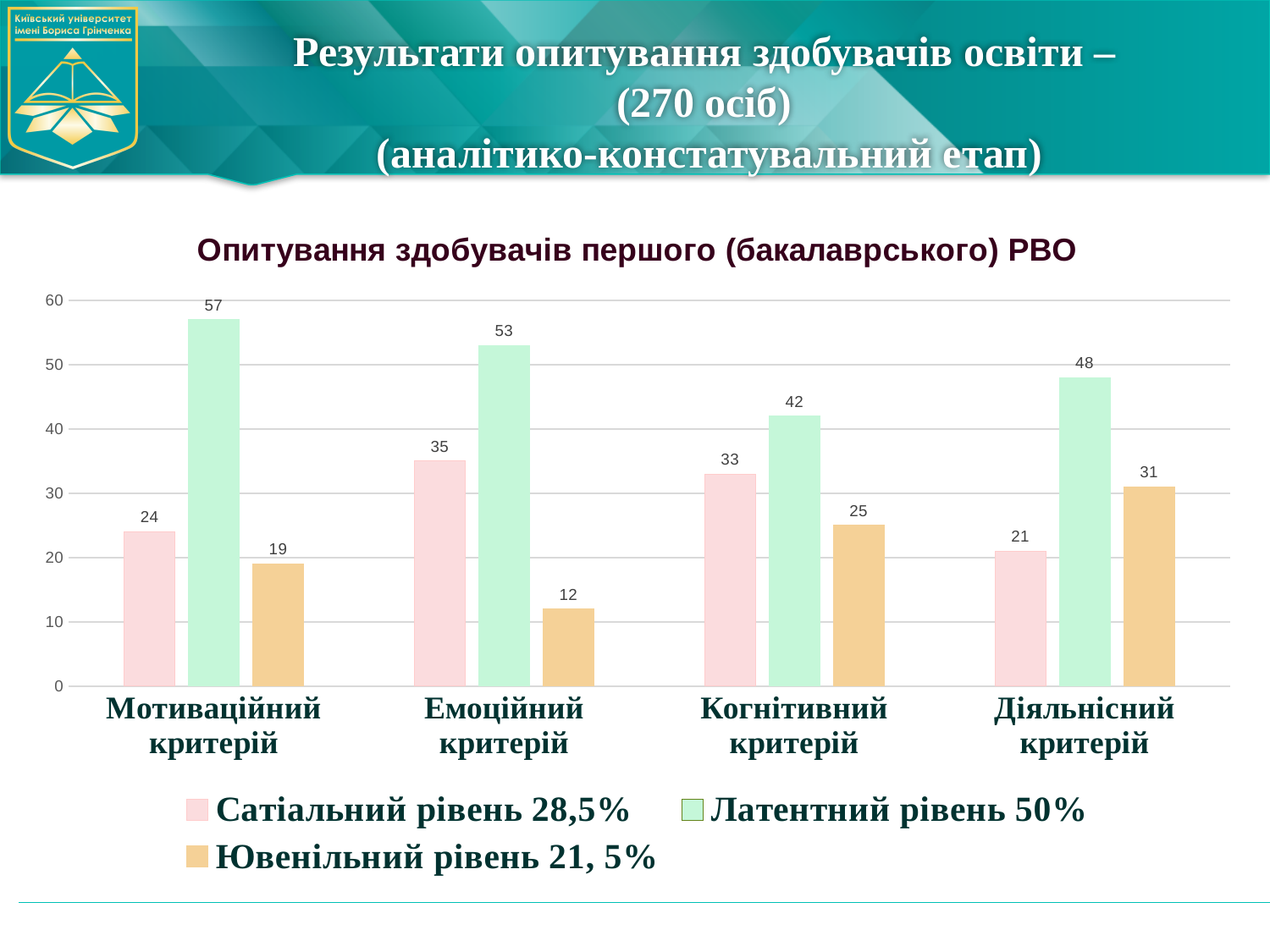
What is the difference between the Латентний рівень 50% and Сатіальний рівень 28,5% values in the Емоційний критерій category? 18 Is the value for Латентний рівень 50% in the Когнітивний критерій category greater or less than 40? greater How many categories are shown on the x axis? 4 What kind of chart is shown on the slide? bar chart How many series does the legend list? 3 What is the title of the chart? Опитування здобувачів першого (бакалаврського) РВО What is the value for Латентний рівень 50% in the Мотиваційний критерій category? 57 Which category has the lowest value for Сатіальний рівень 28,5%? Діяльнісний критерій Which category has the highest value for Латентний рівень 50%? Мотиваційний критерій Which is larger in the Діяльнісний критерій category: Сатіальний рівень 28,5% or Ювенільний рівень 21, 5%? Ювенільний рівень 21, 5% What is the value for Ювенільний рівень 21, 5% in the Емоційний критерій category? 12 What is the value for Сатіальний рівень 28,5% in the Когнітивний критерій category? 33